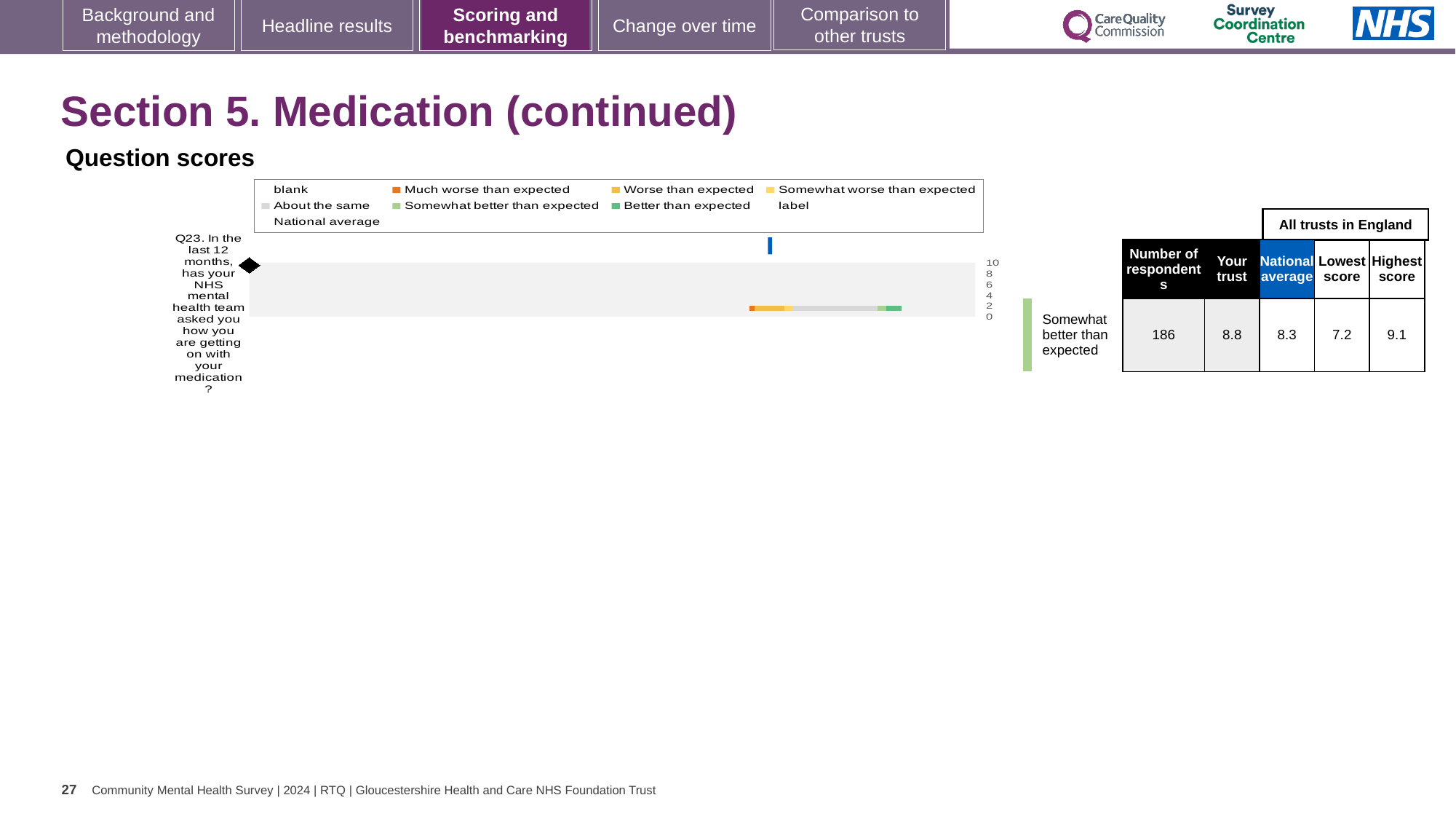
How many respondents answered Q23? 186 What is the highest value shown on the axis of the Question scores chart? 10 What kind of chart is shown under 'Question scores'? bar chart How many entries does the legend of the Question scores chart list? 9 What is the lowest score among all trusts in England for Q23? 7.2 Which is larger for Q23, the 'Your trust' score or the national average? Your trust What is the 'Your trust' score for Q23? 8.8 Which question is plotted in the Question scores chart? Q23. In the last 12 months, has your NHS mental health team asked you how you are getting on with your medication? What is the difference between the 'Your trust' score and the national average for Q23? 0.5 What is the national average score for Q23? 8.3 How many questions (categories) are plotted in the Question scores chart? 1 What is the highest score among all trusts in England for Q23? 9.1